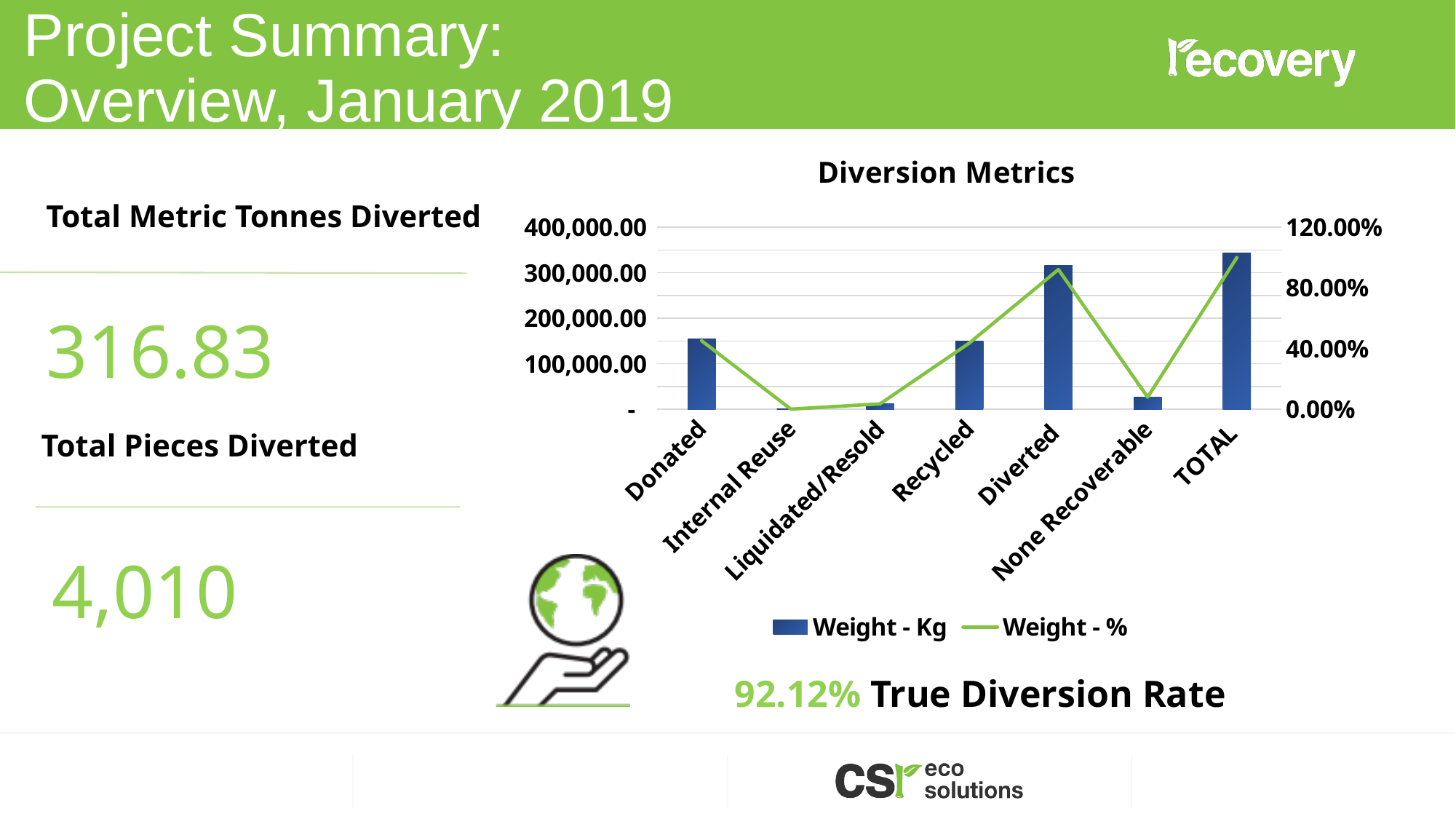
In the Diversion Metrics chart, is the Weight - % value for Diverted greater or less than 80.00%? greater In the Diversion Metrics chart, which has the larger Weight - Kg bar, Diverted or Recycled? Diverted Which category has the tallest Weight - Kg bar in the Diversion Metrics chart? TOTAL In the Diversion Metrics chart, is the Weight - % value for Donated greater or less than 80.00%? less Which category has the lowest Weight - Kg bar in the Diversion Metrics chart? Internal Reuse How many series does the legend of the Diversion Metrics chart list? 2 In the Diversion Metrics chart, is the Weight - Kg bar for None Recoverable greater or less than 100,000.00? less Which series in the Diversion Metrics chart is drawn as a green line? Weight - % What is the title of the chart on the slide? Diversion Metrics What kind of chart is the Diversion Metrics chart? A combined bar and line chart How many categories are shown on the x axis of the Diversion Metrics chart? 7